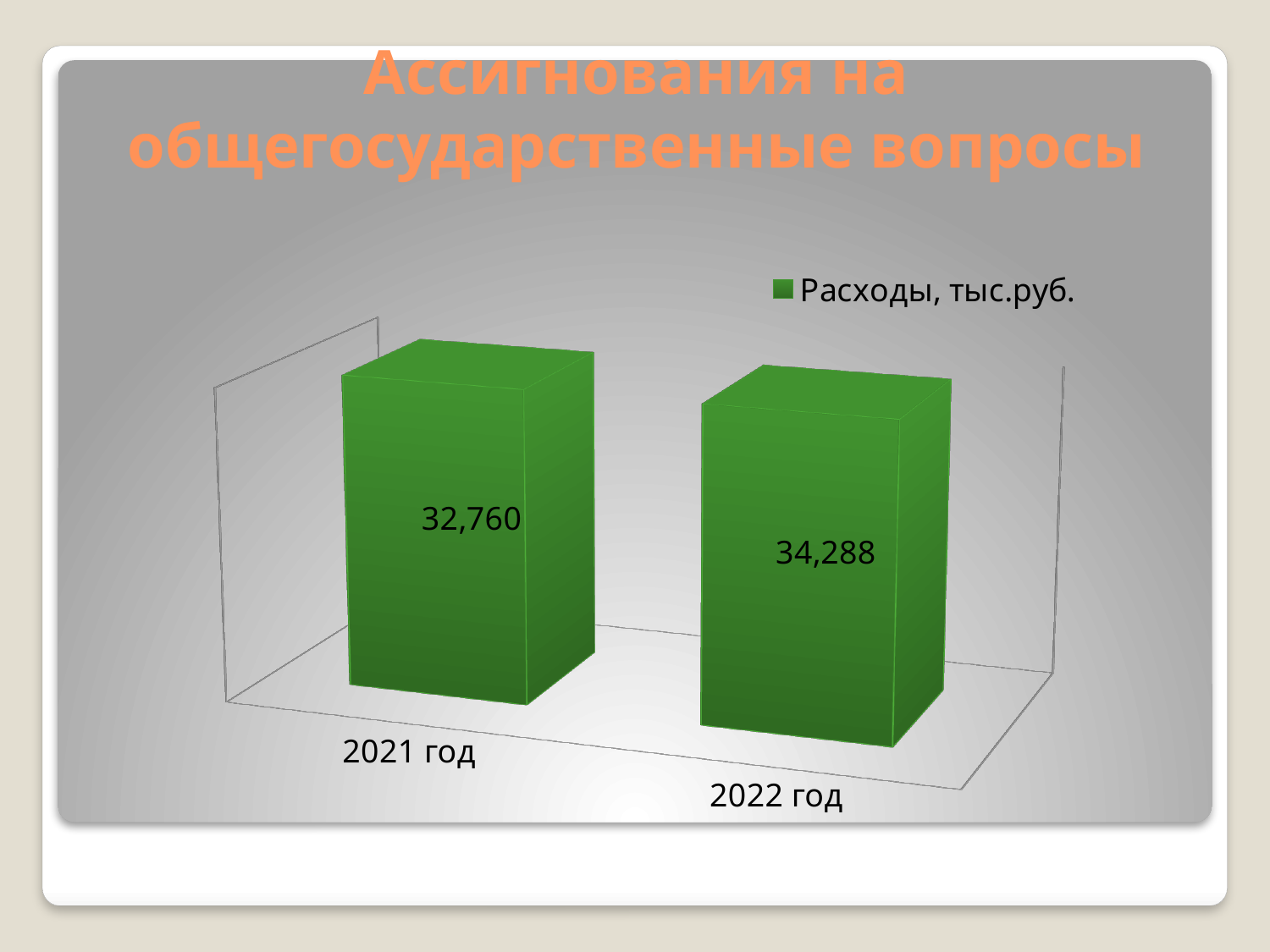
Which year has the lowest value? 2021 год How many series does the legend list? 1 What is the value for 2021 год? 32,760 How many categories are shown on the x axis? 2 What is the value for 2022 год? 34,288 What kind of chart is shown on the slide? Bar chart Which year has the highest value? 2022 год What is the series name shown in the legend? Расходы, тыс.руб. What is the title of the chart? Ассигнования на общегосударственные вопросы What is the difference between the values for 2022 год and 2021 год? 1,528 Which is larger, the value for 2021 год or the value for 2022 год? 2022 год Do the values rise or fall from 2021 год to 2022 год? Rise